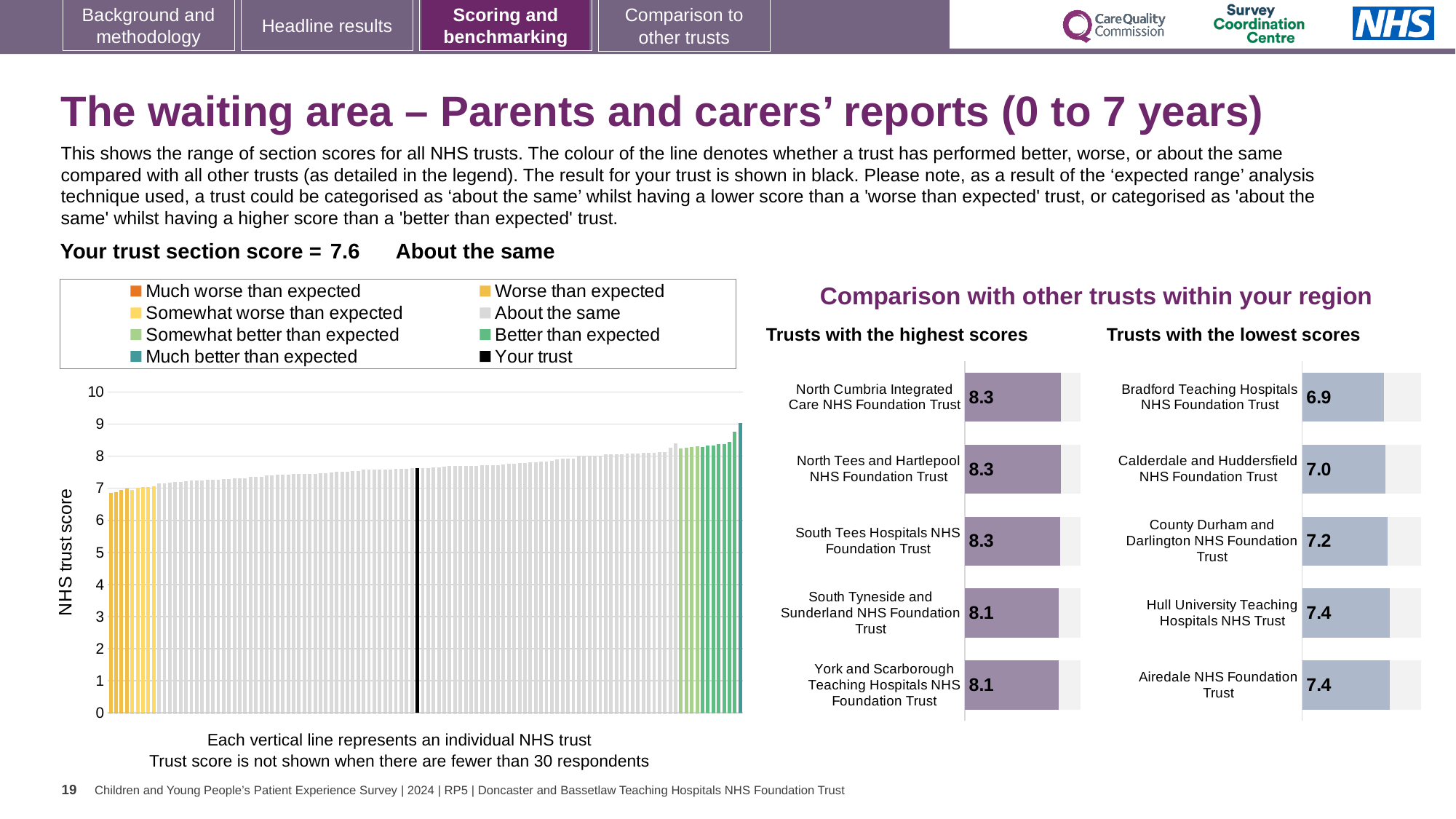
How many trusts are listed in the 'Trusts with the highest scores' chart? 5 What kind of chart is the large chart on the left of the slide? bar chart In the 'Trusts with the lowest scores' chart, what is the difference between the scores of Airedale NHS Foundation Trust and Bradford Teaching Hospitals NHS Foundation Trust? 0.5 In the large chart on the left, is the value for the black bar (your trust) greater or less than 8? less In the large chart on the left, do the bar values rise or fall from left to right? rise What is the y-axis label of the large chart on the left? NHS trust score In the 'Trusts with the lowest scores' chart, which has the higher score: Hull University Teaching Hospitals NHS Trust or Calderdale and Huddersfield NHS Foundation Trust? Hull University Teaching Hospitals NHS Trust In the 'Trusts with the highest scores' chart, what is the score for South Tyneside and Sunderland NHS Foundation Trust? 8.1 How many entries does the legend above the large chart on the left list? 8 In the 'Trusts with the highest scores' chart, what is the difference between the scores of North Cumbria Integrated Care NHS Foundation Trust and York and Scarborough Teaching Hospitals NHS Foundation Trust? 0.2 In the 'Trusts with the lowest scores' chart, which trust has the lowest score? Bradford Teaching Hospitals NHS Foundation Trust In the 'Trusts with the lowest scores' chart, what is the score for County Durham and Darlington NHS Foundation Trust? 7.2